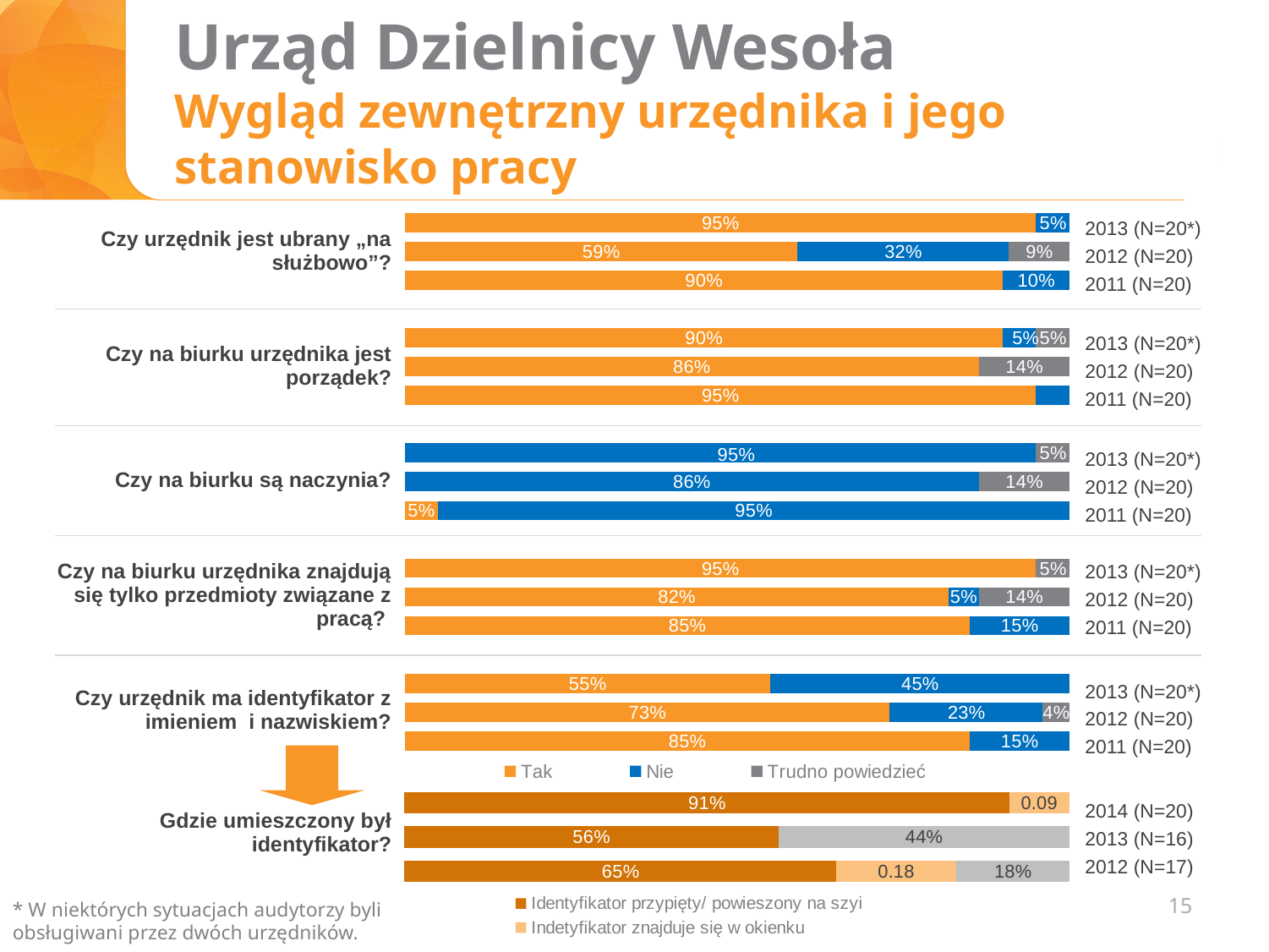
How many series does the legend with "Tak", "Nie" and "Trudno powiedzieć" list? 3 In the chart "Czy urzędnik ma identyfikator z imieniem i nazwiskiem?", what is the difference between the "Tak" values for 2011 (N=20) and 2013 (N=20*)? 30% In the chart "Gdzie umieszczony był identyfikator?", what is the value of "Identyfikator przypięty/ powieszony na szyi" for 2013 (N=16)? 56% In the chart "Czy na biurku urzędnika jest porządek?", what is the "Tak" value for 2012 (N=20)? 86% In the chart "Czy urzędnik jest ubrany „na służbowo”?", what percentage answered "Tak" in 2012 (N=20)? 59% In the chart "Czy urzędnik ma identyfikator z imieniem i nazwiskiem?", what is the "Nie" value for 2013 (N=20*)? 45% In the chart "Czy urzędnik jest ubrany „na służbowo”?", what is the "Nie" value for 2012 (N=20)? 32% In the chart "Czy na biurku są naczynia?", what is the "Tak" value for 2011 (N=20)? 5% In the chart "Gdzie umieszczony był identyfikator?", is the "Identyfikator przypięty/ powieszony na szyi" value larger for 2014 (N=20) or 2012 (N=17)? 2014 (N=20) In the chart "Czy urzędnik ma identyfikator z imieniem i nazwiskiem?", which year has the lowest "Tak" share? 2013 (N=20*) In the chart "Czy na biurku urzędnika znajdują się tylko przedmioty związane z pracą?", what is the "Trudno powiedzieć" value for 2012 (N=20)? 14% In the chart "Czy urzędnik jest ubrany „na służbowo”?", which year has the highest "Tak" share? 2013 (N=20*)